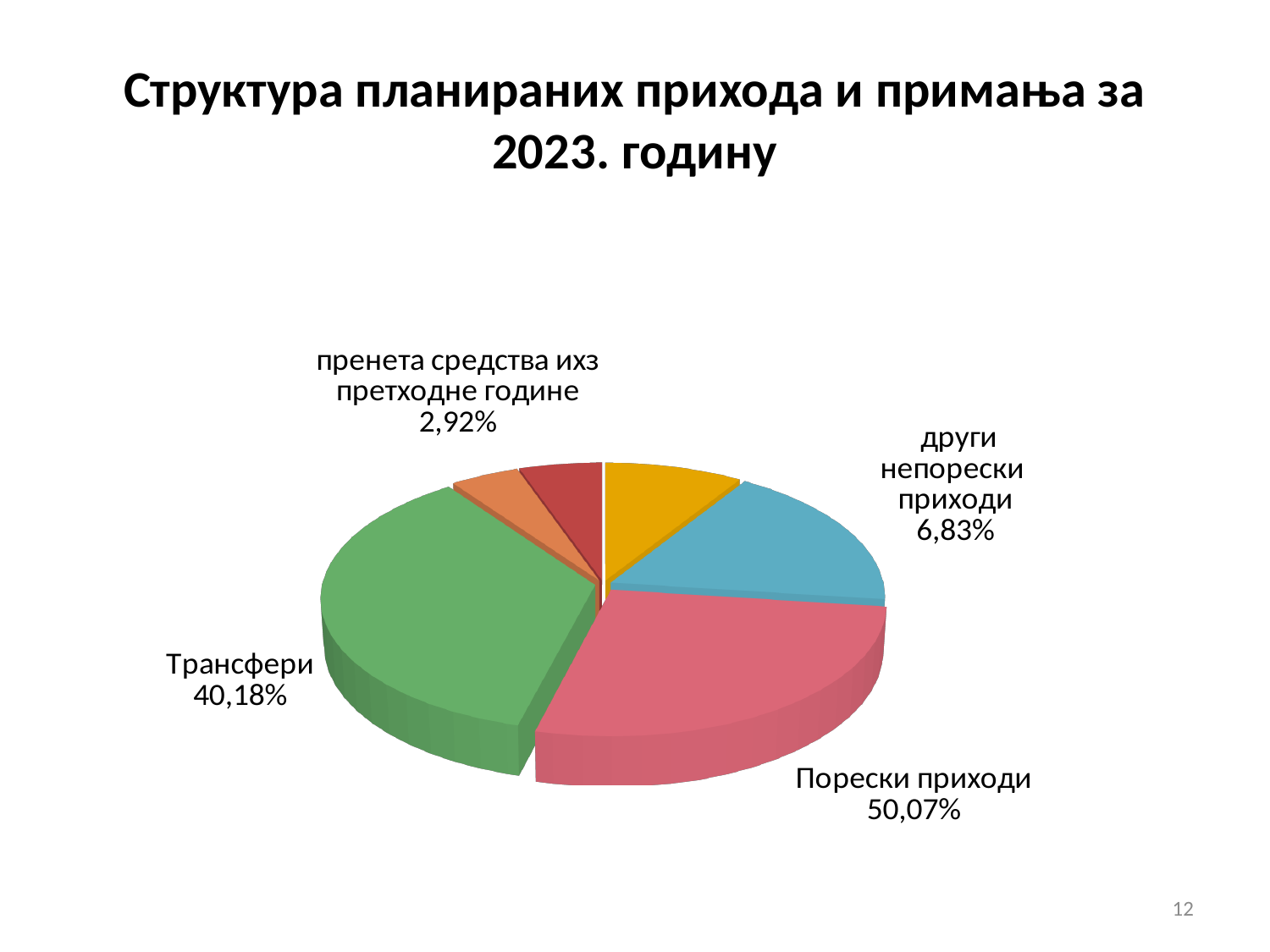
What percentage is shown for пренета средства ихз претходне године? 2,92% What is the title of the slide? Структура планираних прихода и примања за 2023. годину What kind of chart is shown on the slide? Pie chart Which is larger, the share for други непорески приходи or the share for пренета средства ихз претходне године? други непорески приходи What value is labelled for други непорески приходи? 6,83% What is the difference in percentage points between Порески приходи and Трансфери? 9,89 What is the difference in percentage points between други непорески приходи and пренета средства ихз претходне године? 3,91 Which labelled category has the largest share of the pie? Порески приходи What percentage is shown for Трансфери? 40,18% What share of the pie does Порески приходи represent? 50,07% Which is larger, the share for Трансфери or the share for Порески приходи? Порески приходи Which labelled category has the smallest share of the pie? пренета средства ихз претходне године